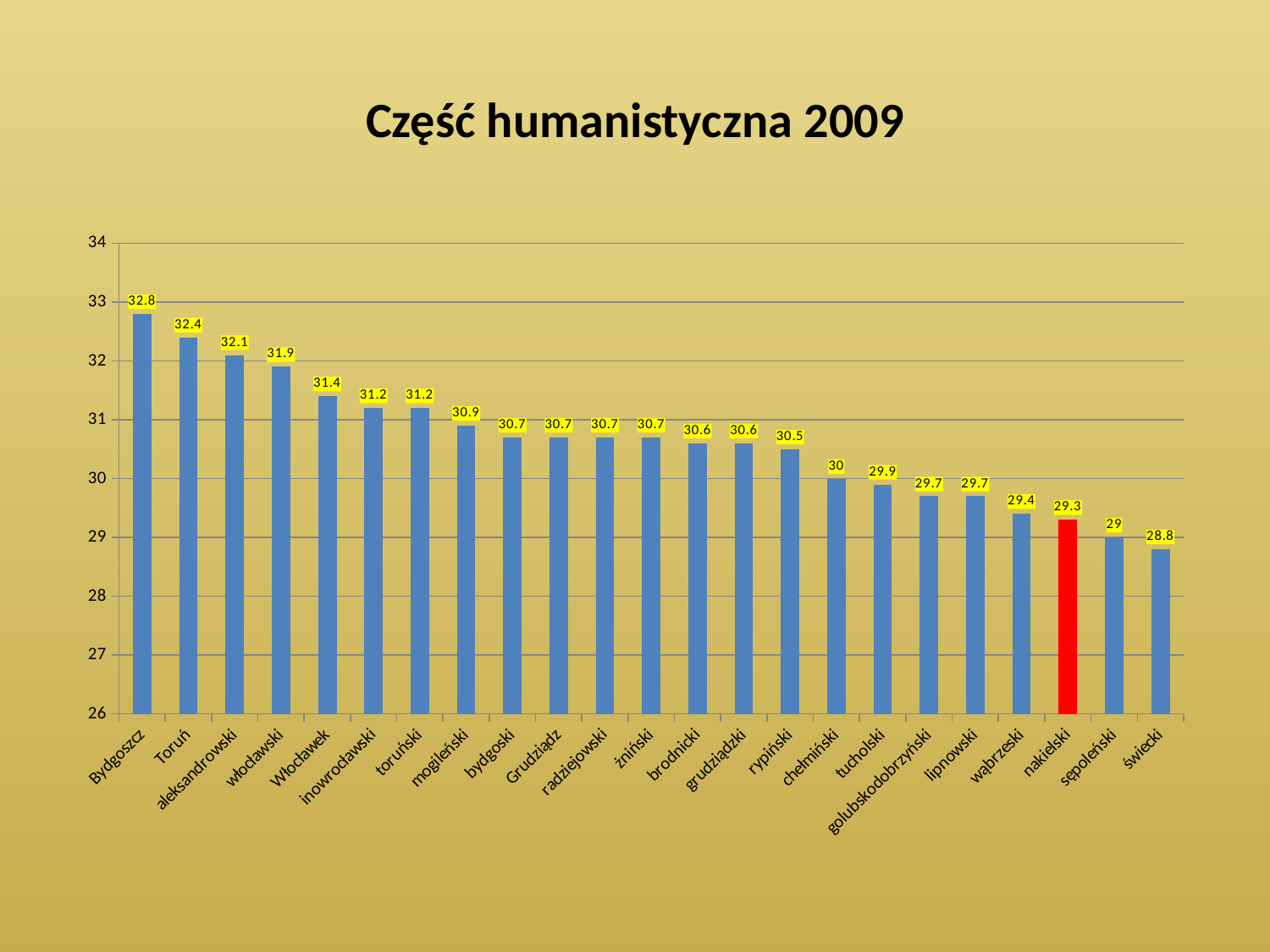
What is the difference between the values for Bydgoszcz and świecki? 4 Which category has the highest value? Bydgoszcz How many categories are shown on the x axis? 23 Which is larger, the value for Toruń or the value for Włocławek? Toruń Which category has the lowest value? świecki What is the value for chełmiński? 30 Do the values rise or fall from left to right along the x axis? Fall What is the value for mogileński? 30.9 Which category's bar is coloured red? nakielski What is the value for nakielski? 29.3 What is the value for Bydgoszcz? 32.8 What kind of chart is shown on the slide? Bar chart